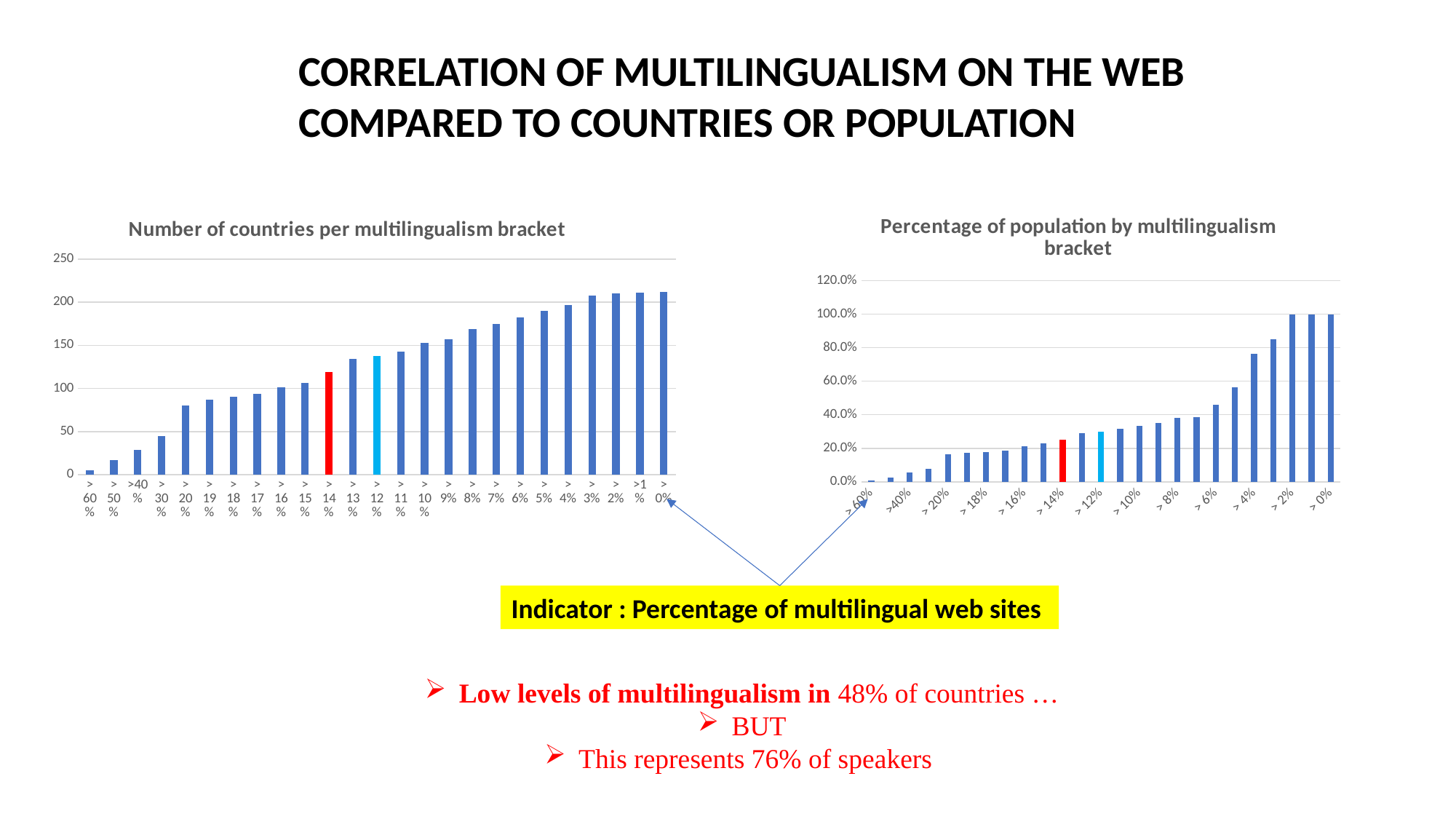
What kind of chart is the 'Number of countries per multilingualism bracket' chart? bar chart In the 'Number of countries per multilingualism bracket' chart, is the value for >0% greater or less than 200? greater In the 'Number of countries per multilingualism bracket' chart, is the value for >60% greater or less than 50? less In the 'Number of countries per multilingualism bracket' chart, is the value for >14% greater or less than 100? greater In the 'Percentage of population by multilingualism bracket' chart, which category has the lowest value? >60% In the 'Number of countries per multilingualism bracket' chart, which is larger, the value for >14% or the value for >12%? >12% How many categories are plotted in the 'Number of countries per multilingualism bracket' chart? 25 In the 'Number of countries per multilingualism bracket' chart, do the values rise or fall from left to right along the x axis? rise In the 'Number of countries per multilingualism bracket' chart, which category has the lowest value? >60% In the 'Number of countries per multilingualism bracket' chart, which category is drawn with a red bar? >14%